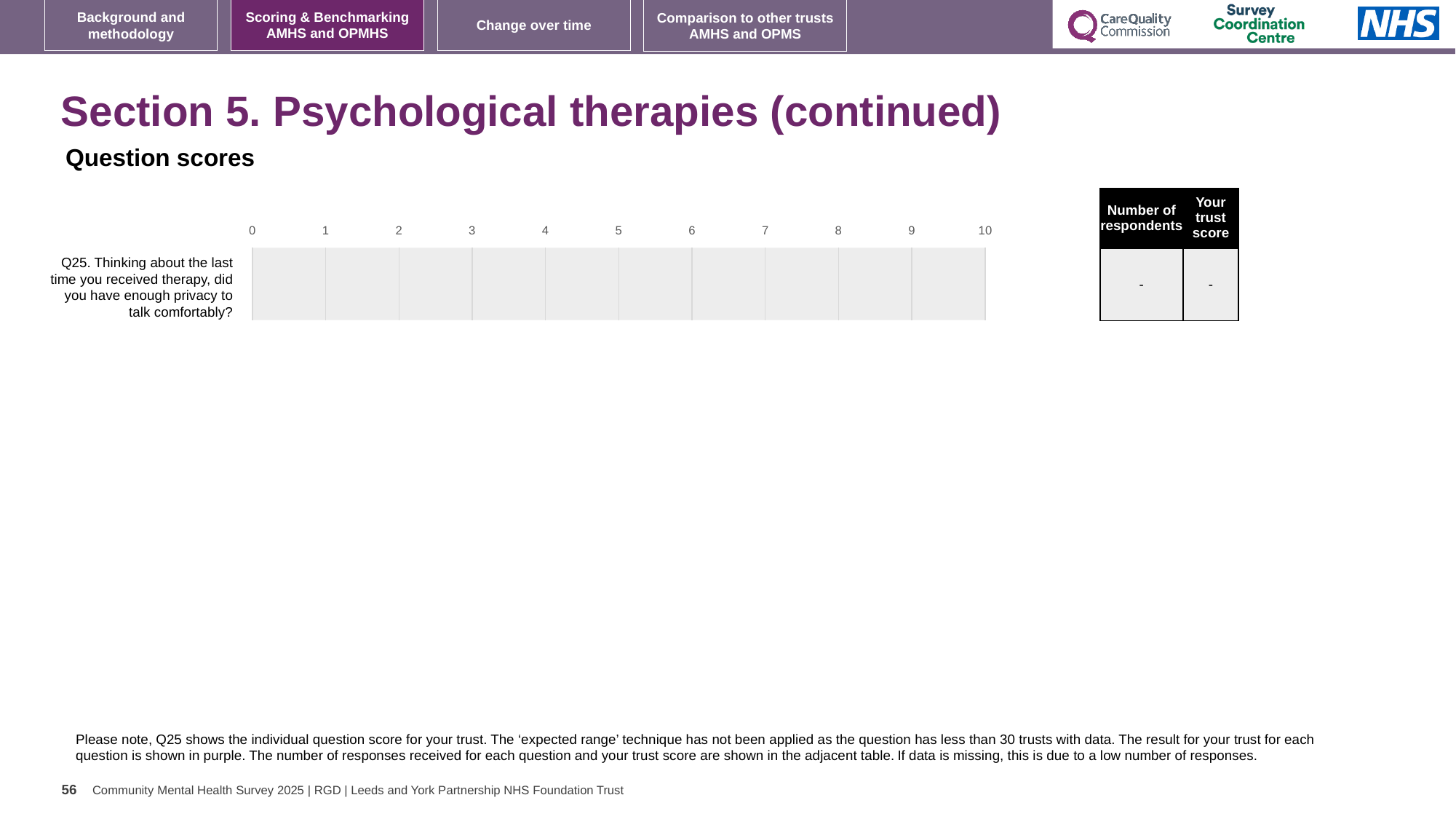
What is the highest value shown on the chart's horizontal axis? 10 What is shown in the 'Your trust score' column for Q25? - Is a bar plotted for Q25 on the chart? No What is the lowest value shown on the chart's horizontal axis? 0 What is shown in the 'Number of respondents' column for Q25? - How many questions (categories) are shown on the chart? 1